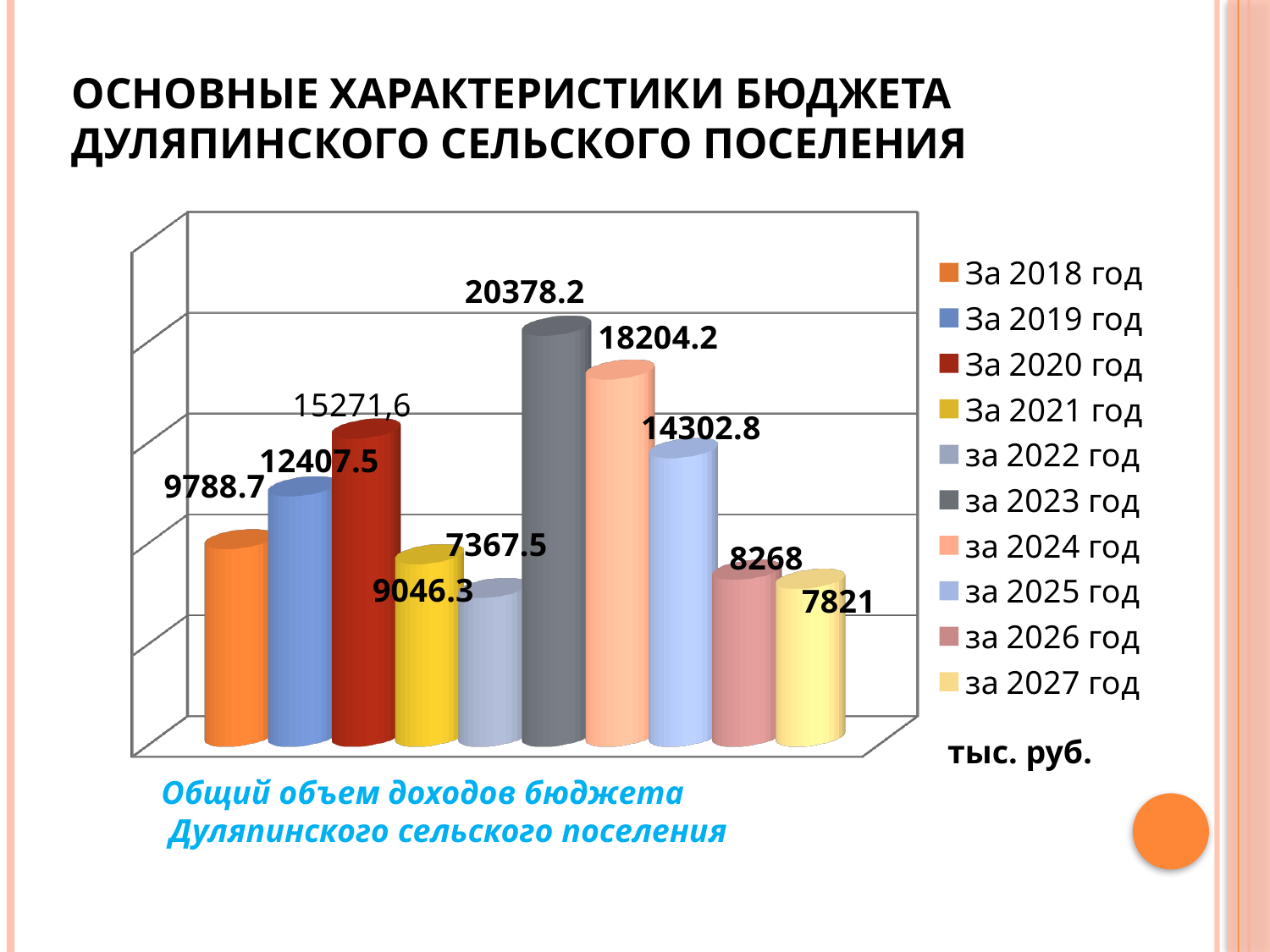
Which is larger, the value for 2019 or the value for 2025? 2025 (14302.8) Which year has the lowest value in the chart? за 2022 год What is the value for 2018 (За 2018 год) in the chart? 9788.7 What is the value for 2023 (за 2023 год) in the chart? 20378.2 Which year has the highest value in the chart? за 2023 год What is the difference between the values for 2026 and 2027? 447 What is the value for 2020 (За 2020 год) in the chart? 15271,6 What unit is indicated below the legend of the chart? тыс. руб. What is the value for 2027 (за 2027 год) in the chart? 7821 What is the difference between the values for 2023 and 2024? 2174 How many entries does the legend list? 10 What kind of chart is shown on the slide? Bar chart